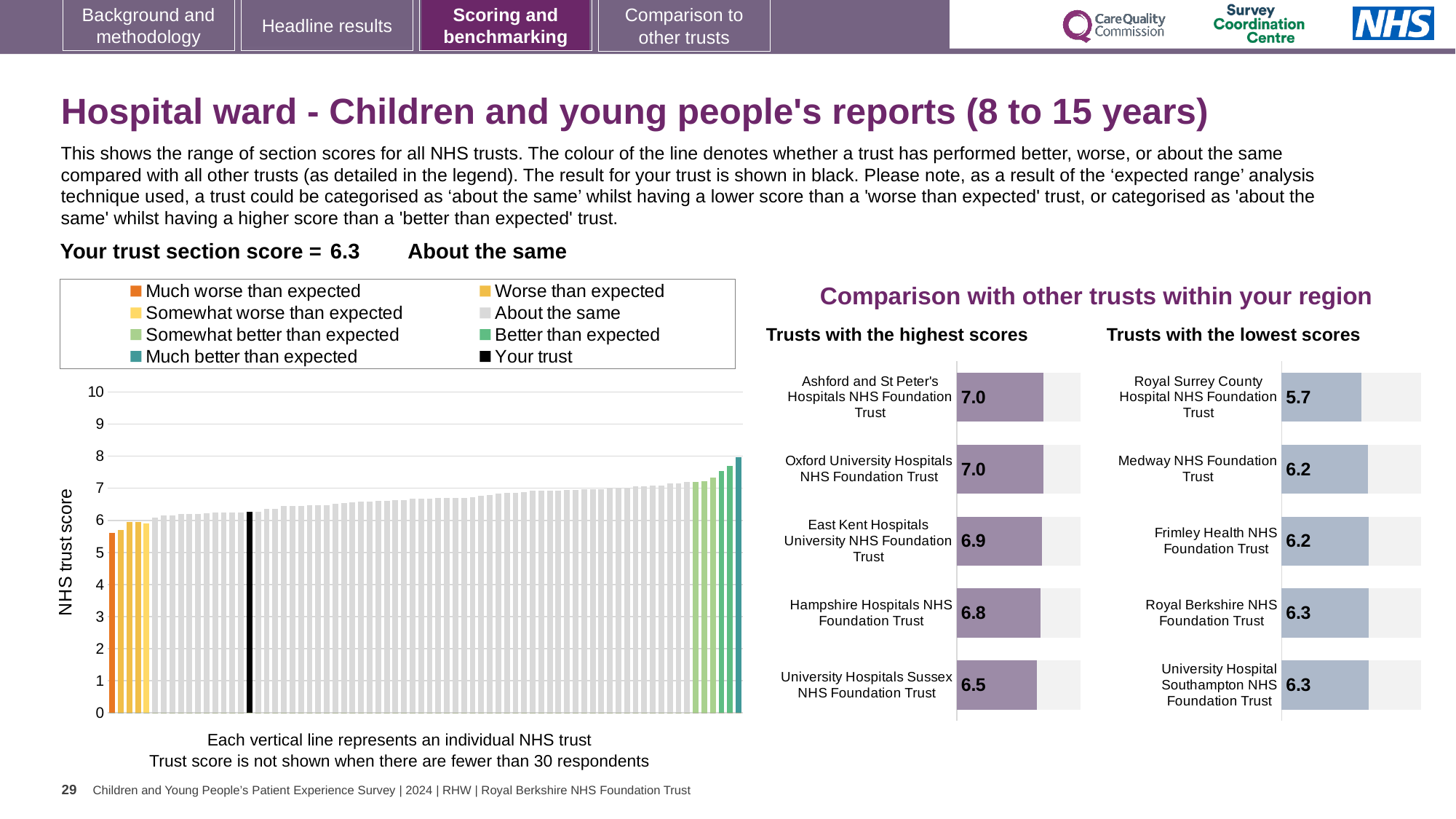
In the 'Trusts with the lowest scores' chart, what is the score for Royal Surrey County Hospital NHS Foundation Trust? 5.7 In the 'Trusts with the highest scores' chart, what is the score for Hampshire Hospitals NHS Foundation Trust? 6.8 In the 'Trusts with the highest scores' chart, what is the score for Ashford and St Peter's Hospitals NHS Foundation Trust? 7.0 How many trusts are shown in the 'Trusts with the lowest scores' chart? 5 In the 'Trusts with the lowest scores' chart, what is the difference between the scores of Royal Berkshire NHS Foundation Trust and Royal Surrey County Hospital NHS Foundation Trust? 0.6 How many entries does the legend of the large chart on the left list? 8 In the 'Trusts with the lowest scores' chart, which has the larger score: Medway NHS Foundation Trust or Royal Surrey County Hospital NHS Foundation Trust? Medway NHS Foundation Trust In the 'Trusts with the highest scores' chart, which trust has the lowest score? University Hospitals Sussex NHS Foundation Trust In the large chart on the left, do the trust scores rise or fall from left to right? Rise In the 'Trusts with the highest scores' chart, what is the difference between the scores of Ashford and St Peter's Hospitals NHS Foundation Trust and University Hospitals Sussex NHS Foundation Trust? 0.5 In the 'Trusts with the lowest scores' chart, which trust has the lowest score? Royal Surrey County Hospital NHS Foundation Trust What kind of chart is the large chart on the left showing NHS trust scores? Bar chart